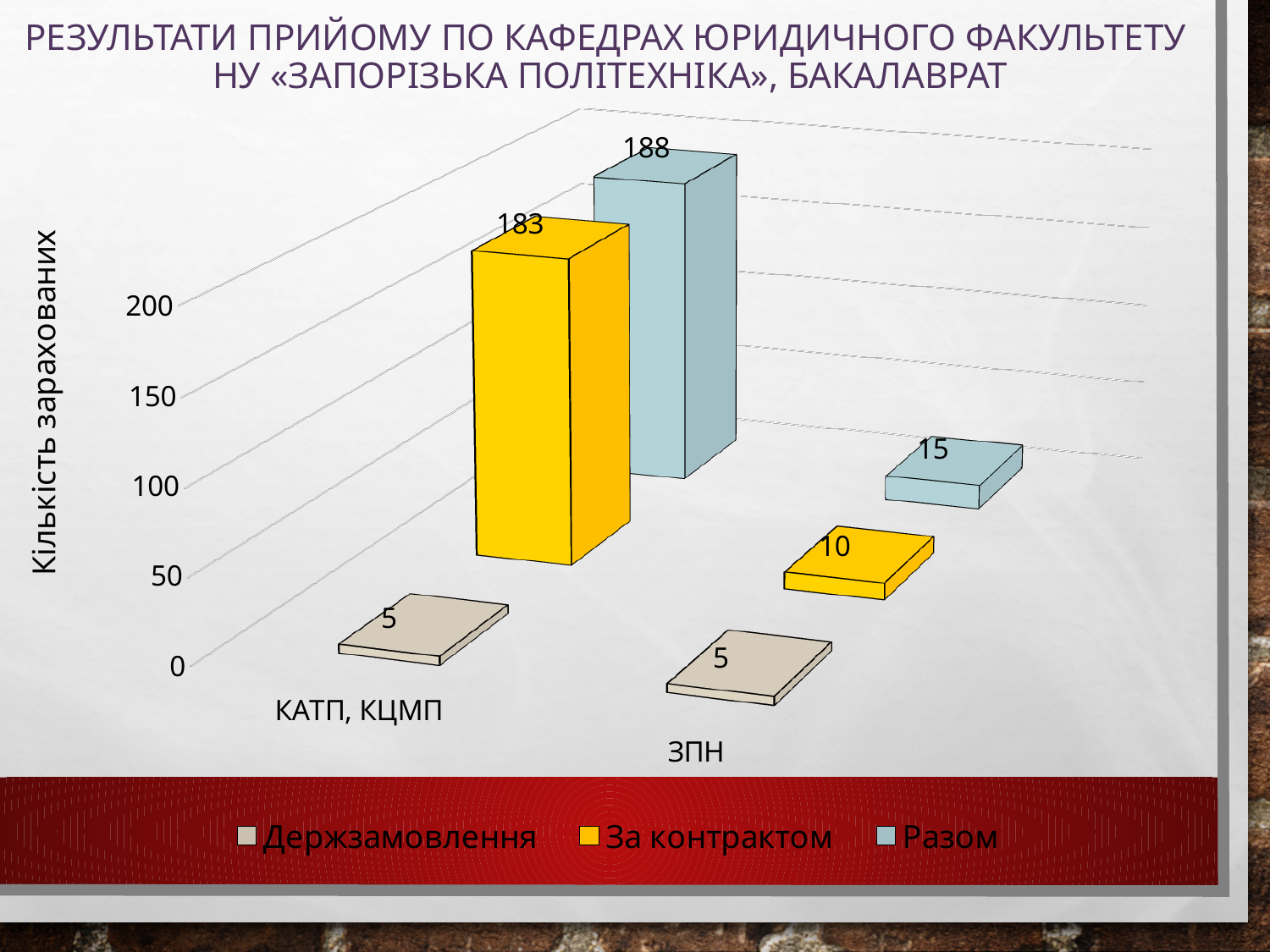
What is the label of the vertical axis? Кількість зарахованих Which is larger: За контрактом for КАТП, КЦМП or За контрактом for ЗПН? КАТП, КЦМП What kind of chart is shown on the slide? Bar chart What is the value of За контрактом for ЗПН? 10 What is the difference between the Разом values for КАТП, КЦМП and ЗПН? 173 Which category has the lowest За контрактом value? ЗПН How many series does the legend list? 3 What is the value of За контрактом for КАТП, КЦМП? 183 Which category has the highest Разом value? КАТП, КЦМП How many categories are shown on the x axis? 2 What is the value of Разом for ЗПН? 15 What is the value of Держзамовлення for ЗПН? 5